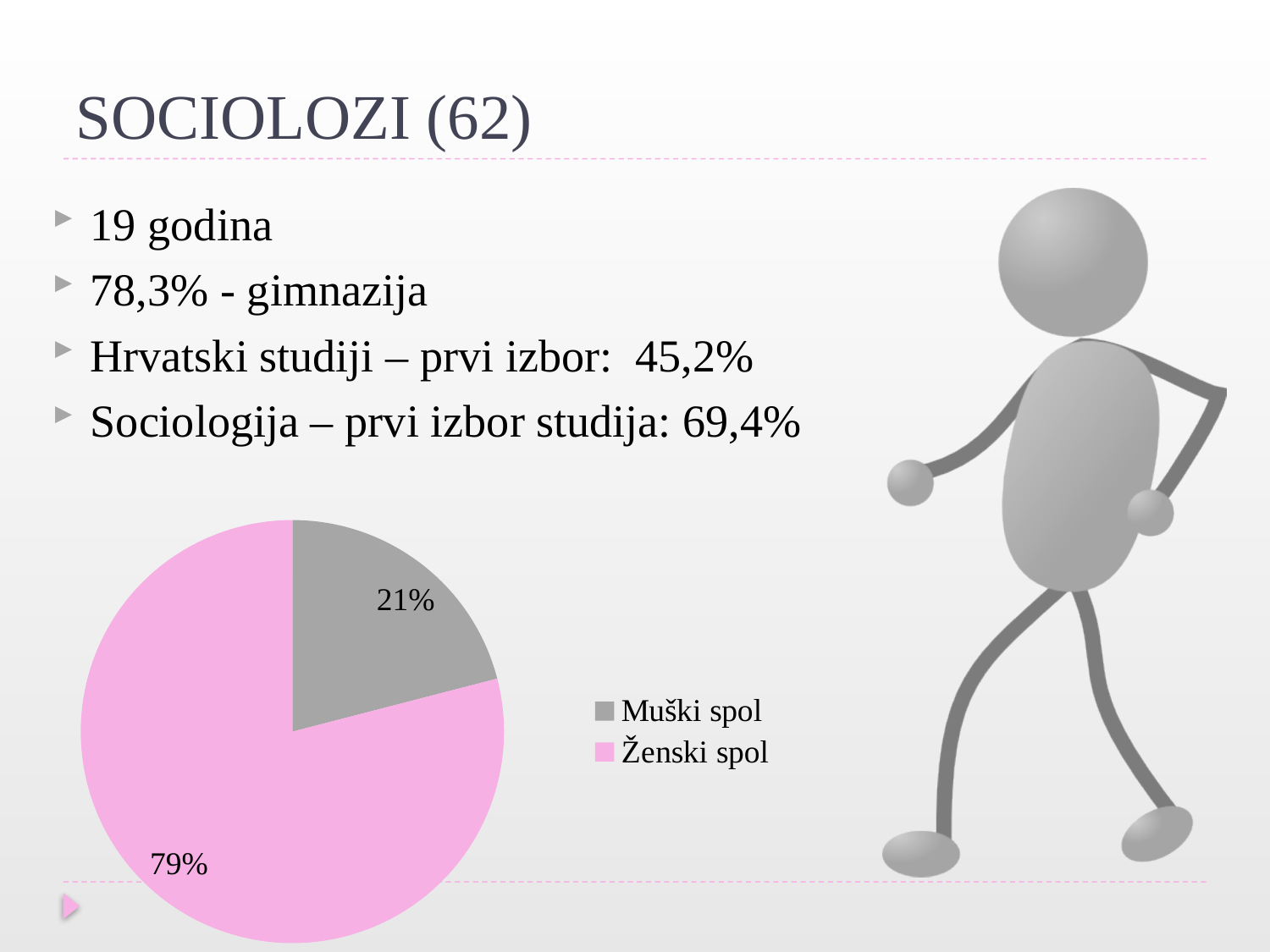
Which category has the smallest slice of the pie? Muški spol What share of the pie does Ženski spol have? 79% How many entries does the legend list? 2 What colour is the slice for Ženski spol? pink What kind of chart is shown on the slide? pie chart How many slices does the pie chart have? 2 What is the difference in percentage points between Ženski spol and Muški spol? 58 Which category has the largest slice of the pie? Ženski spol Which is larger, the slice for Muški spol or the slice for Ženski spol? Ženski spol What colour is the slice for Muški spol? grey What share of the pie does Muški spol have? 21%